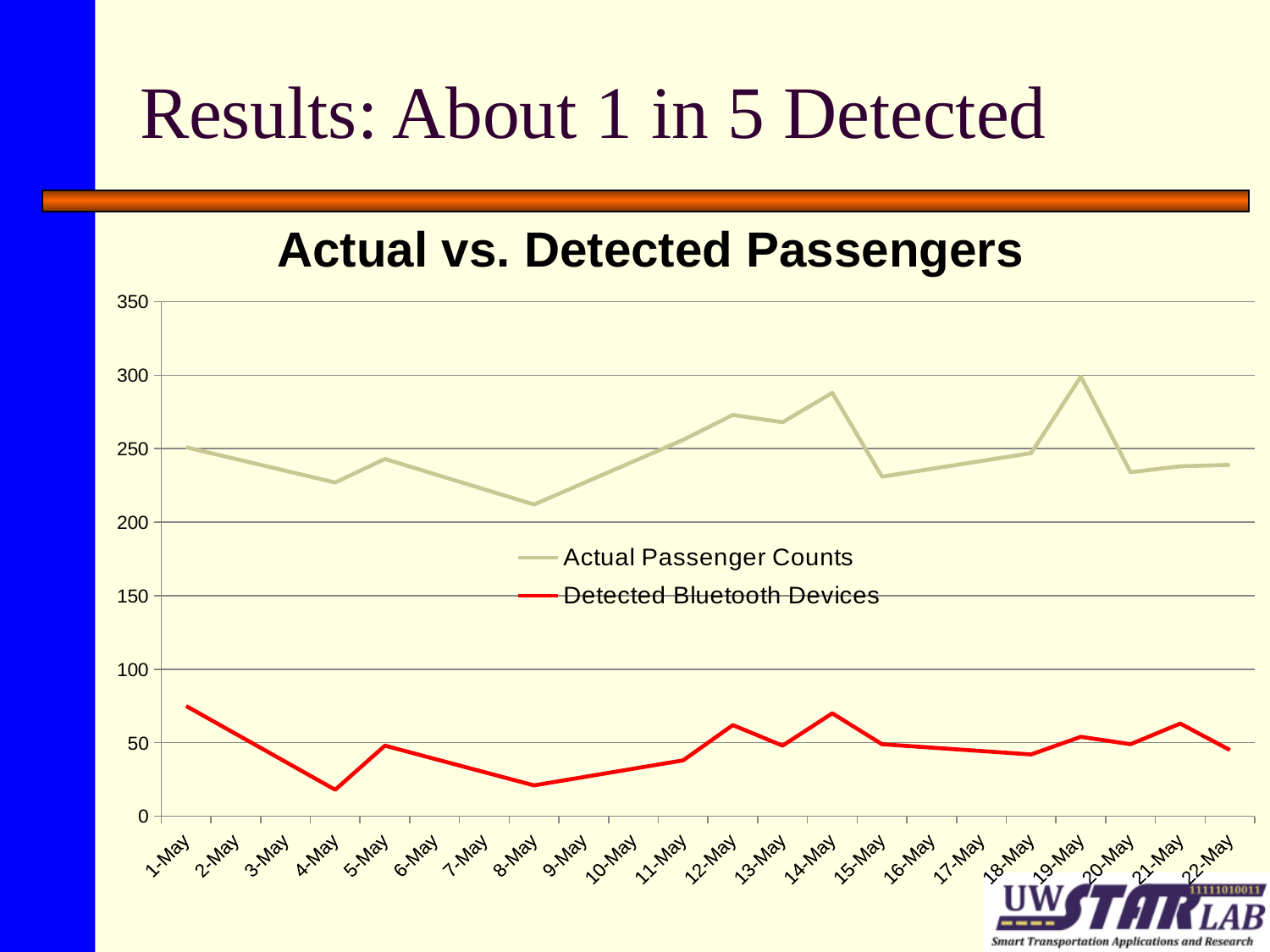
On 14-May, which series has the larger value, Actual Passenger Counts or Detected Bluetooth Devices? Actual Passenger Counts Is the Detected Bluetooth Devices value on 4-May greater or less than 50? less How many dates are plotted along the x axis? 22 On which date is the Actual Passenger Counts value lowest? 8-May Do the Actual Passenger Counts rise or fall from 8-May to 14-May? rise Is the Actual Passenger Counts value on 8-May greater or less than 250? less What kind of chart is shown on the slide? line chart Is the Detected Bluetooth Devices value on 1-May greater or less than 50? greater How many series does the legend list? 2 On which date is the Actual Passenger Counts value highest? 19-May What is the title of the chart? Actual vs. Detected Passengers